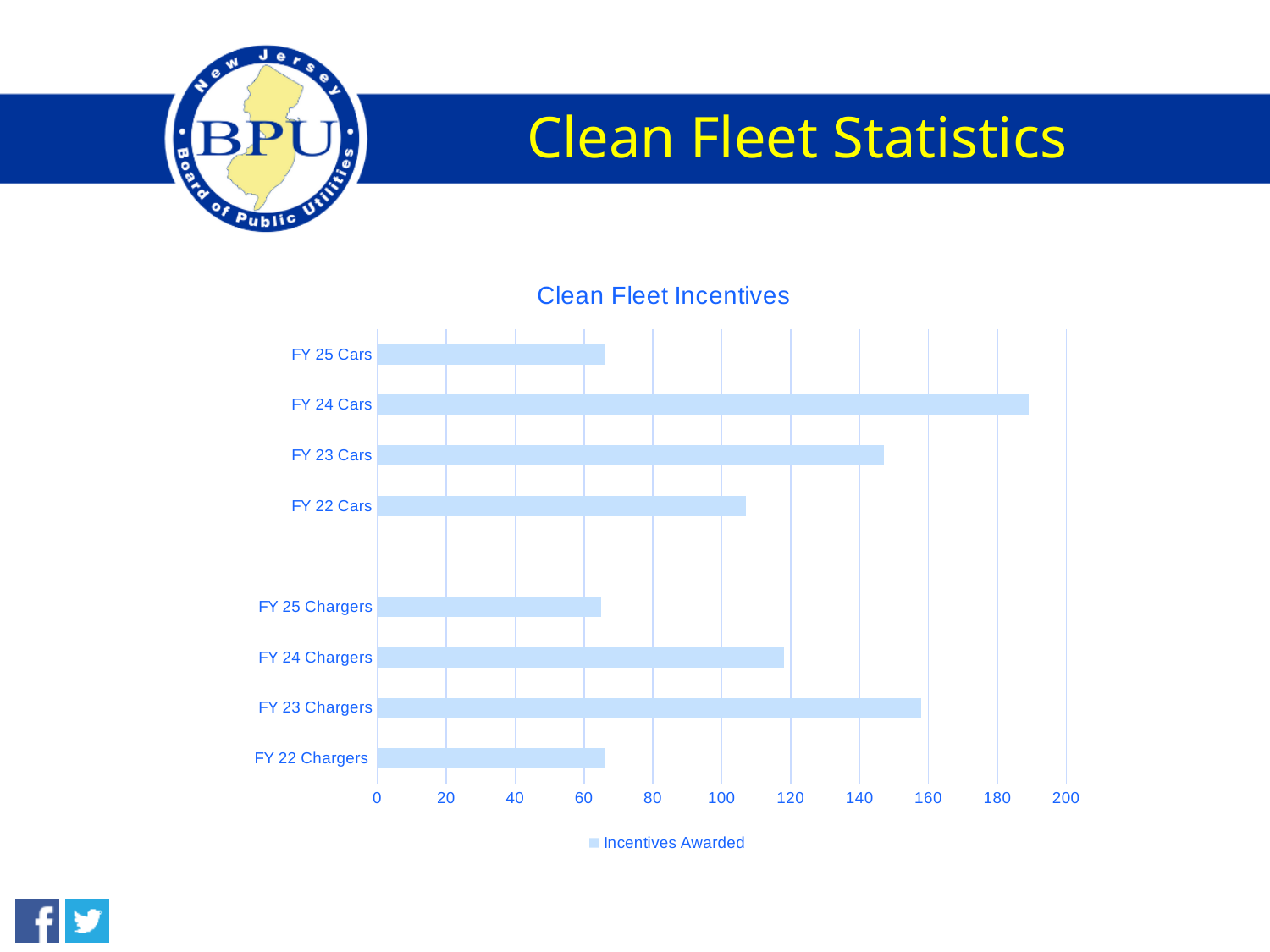
Is the value for FY 24 Cars greater or less than 180? greater What is the title of the chart? Clean Fleet Incentives Which is larger, the value for FY 23 Cars or FY 22 Cars? FY 23 Cars Which is larger, the value for FY 23 Chargers or FY 24 Chargers? FY 23 Chargers Which category has the highest number of incentives awarded? FY 24 Cars Is the value for FY 23 Cars greater or less than 140? greater Is the value for FY 22 Cars greater or less than 100? greater What is the name of the series shown in the legend? Incentives Awarded What kind of chart is shown on the slide? Bar chart How many series does the legend list? 1 How many categories are plotted on the chart? 8